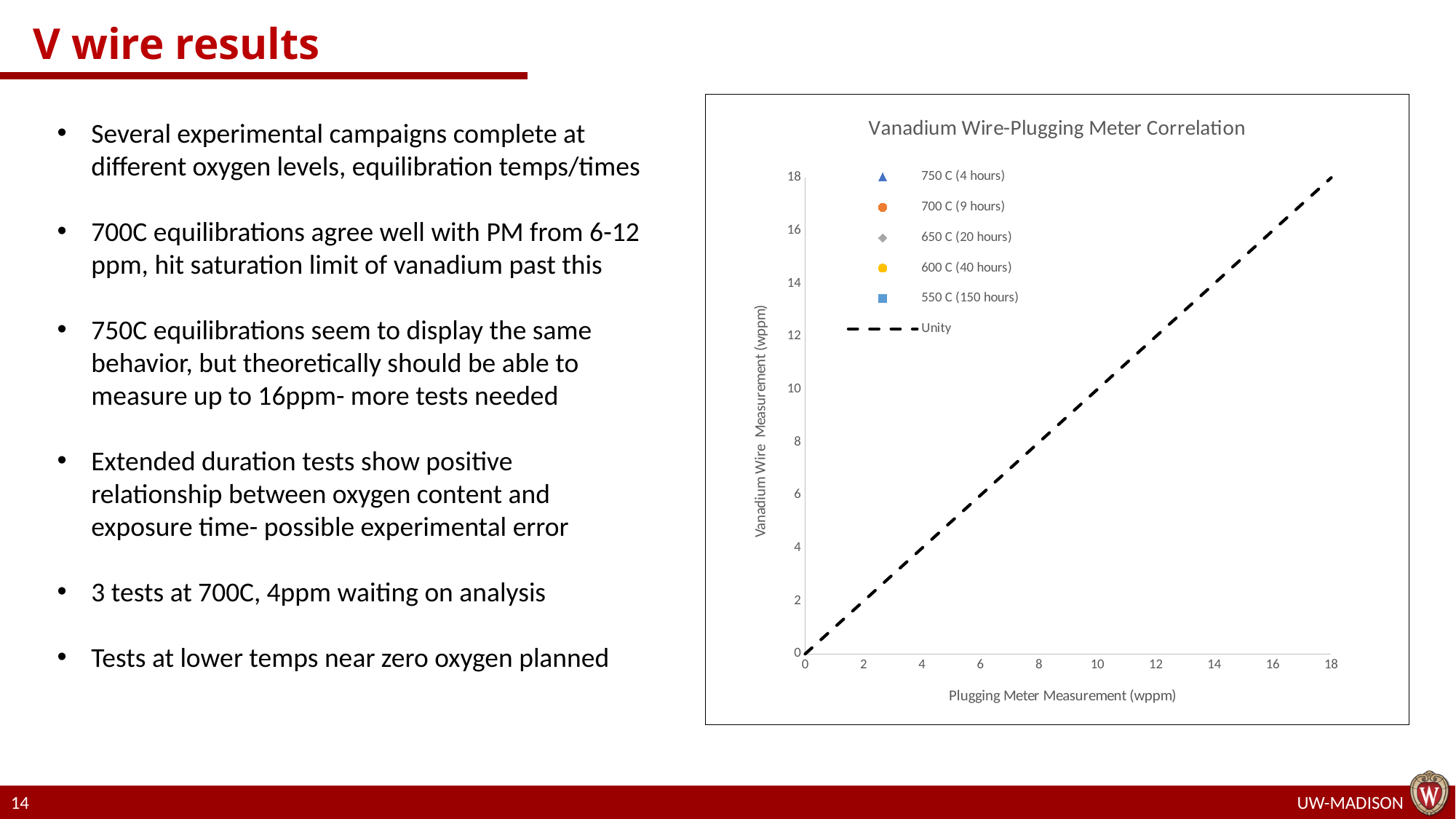
Is the Unity line's value at a Plugging Meter Measurement of 4 wppm greater or less than 8? less What Vanadium Wire Measurement does the Unity line reach at a Plugging Meter Measurement of 18 wppm? 18 What is the label of the x axis of the chart? Plugging Meter Measurement (wppm) What is the title of the chart? Vanadium Wire-Plugging Meter Correlation How many series does the chart legend list? 6 What Vanadium Wire Measurement does the Unity line have at a Plugging Meter Measurement of 0 wppm? 0 Is the Unity line's value at a Plugging Meter Measurement of 14 wppm greater or less than 10? greater Does the Unity line rise or fall as the Plugging Meter Measurement increases? rises What kind of chart is shown on the slide? scatter chart